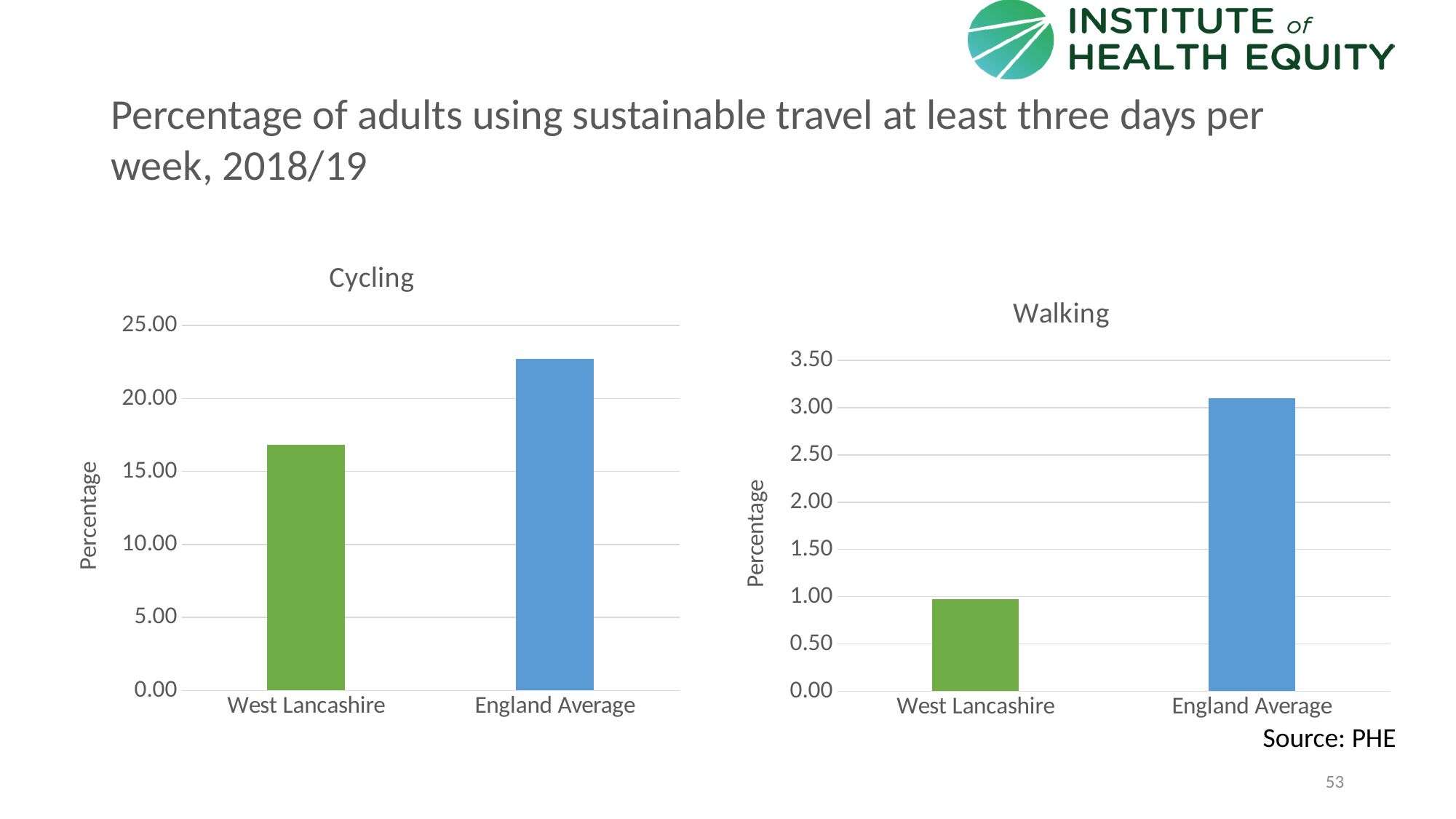
In the Cycling chart, which category has the lowest value? West Lancashire How many categories are shown in the Cycling chart? 2 In the Cycling chart, is the value for West Lancashire greater or less than 15.00? greater In the Walking chart, which is larger, the value for West Lancashire or the value for England Average? England Average What type of chart is the Cycling chart? bar chart In the Walking chart, which category has the highest value? England Average In the Cycling chart, is the value for England Average greater or less than 20.00? greater What is the y-axis label on the Walking chart? Percentage In the Walking chart, is the value for West Lancashire greater or less than 1.50? less In the Cycling chart, which category has the highest value? England Average